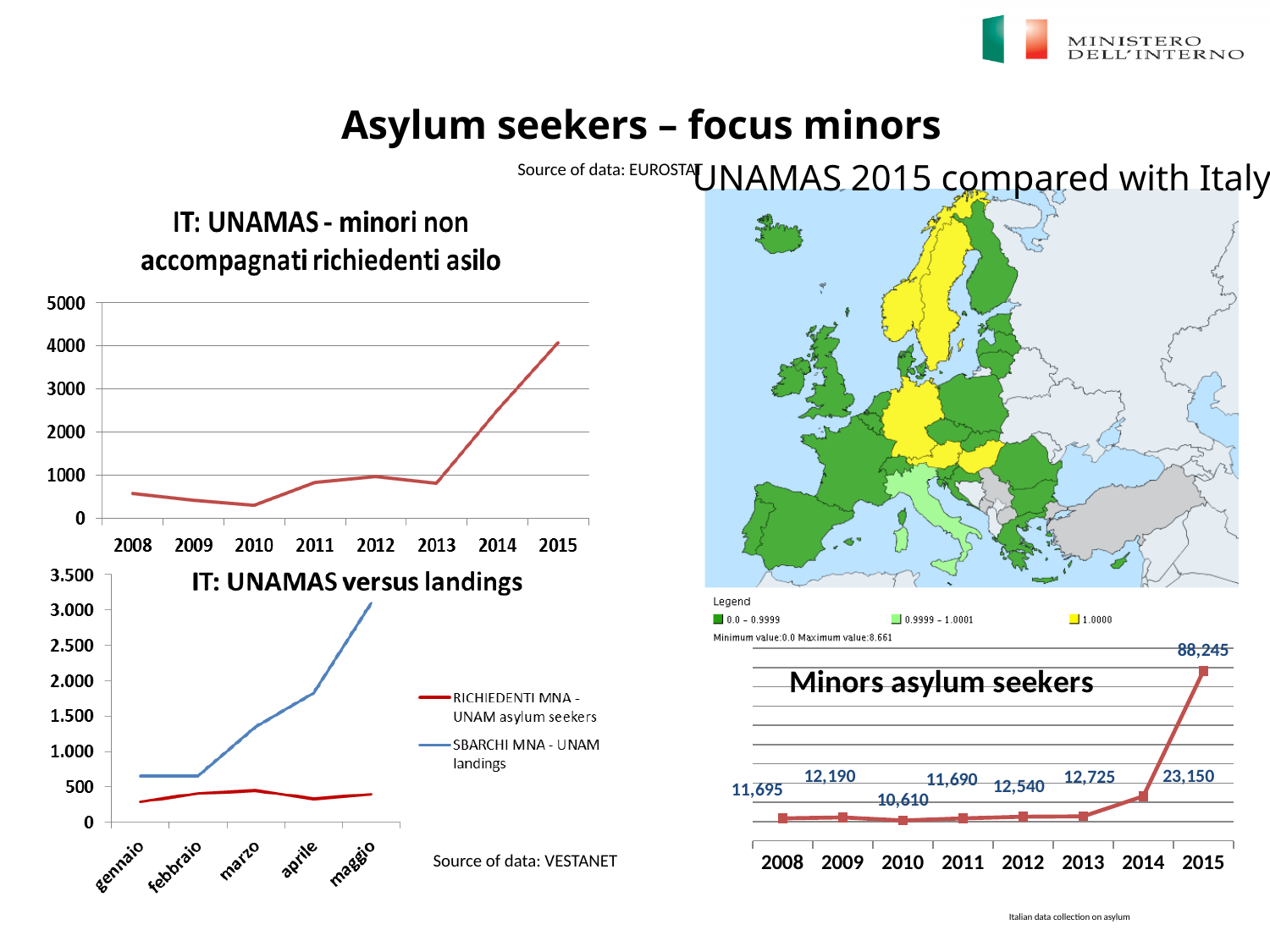
In the "IT: UNAMAS versus landings" chart, is the value for SBARCHI MNA - UNAM landings in maggio greater or less than 2.500? greater In the "IT: UNAMAS - minori non accompagnati richiedenti asilo" chart, is the value for 2015 greater or less than 3000? greater In the "Minors asylum seekers" chart, what is the value for 2015? 88,245 In the "Minors asylum seekers" chart, which year has the lowest value? 2010 How many series does the legend of the "IT: UNAMAS versus landings" chart list? 2 In the "Minors asylum seekers" chart, what is the difference between the 2015 and 2014 values? 65,095 In the "Minors asylum seekers" chart, which is larger, the value for 2009 or the value for 2011? 2009 How many years are plotted in the "Minors asylum seekers" chart? 8 In the "Minors asylum seekers" chart, what is the value for 2014? 23,150 In the "Minors asylum seekers" chart, what is the value for 2010? 10,610 What kind of chart is "IT: UNAMAS - minori non accompagnati richiedenti asilo"? line chart In the "Minors asylum seekers" chart, which year has the highest value? 2015